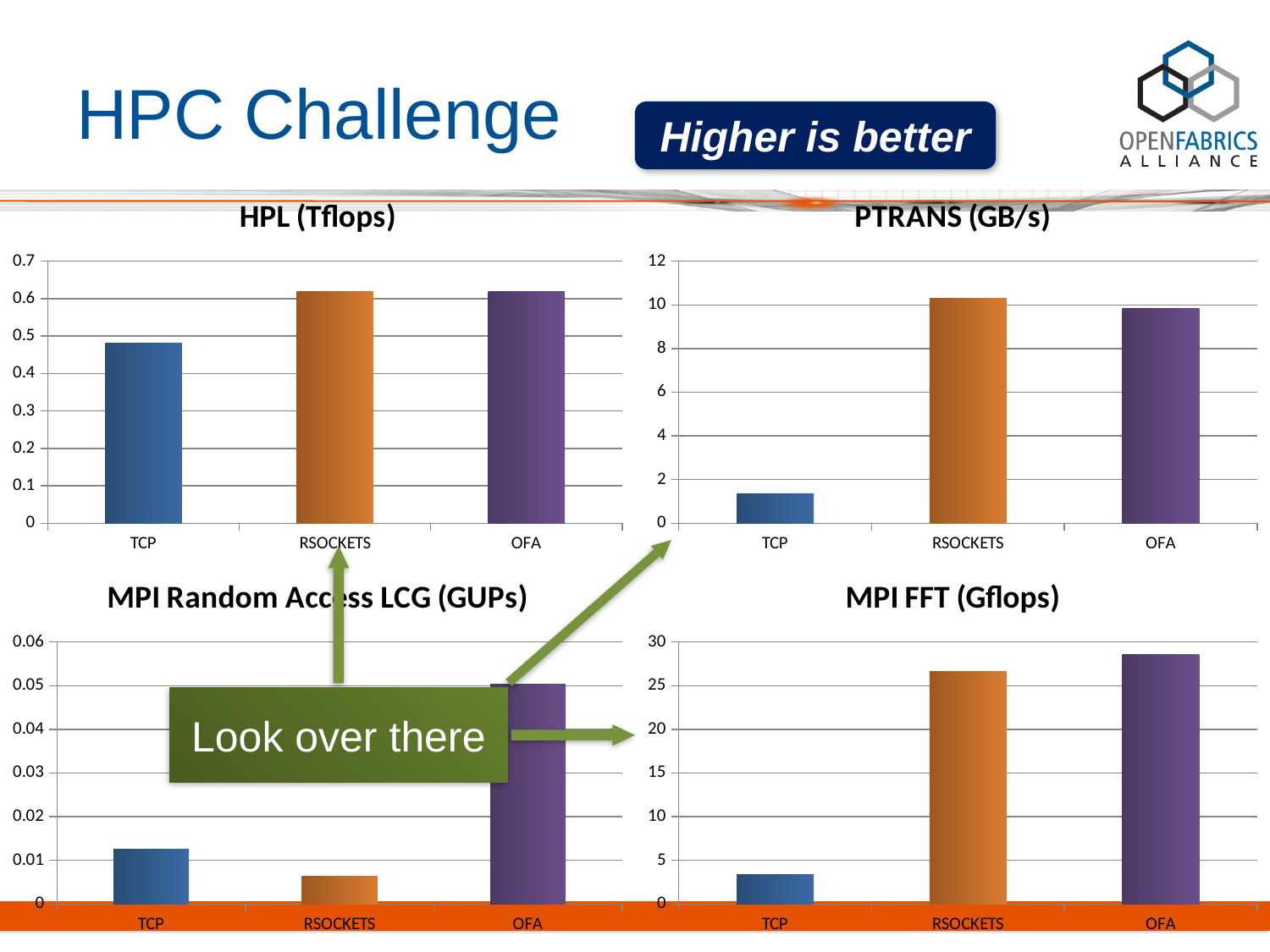
In the MPI Random Access LCG (GUPs) chart, which category has the highest value? OFA In the MPI FFT (Gflops) chart, is the value for RSOCKETS greater or less than 25? greater In the HPL (Tflops) chart, which category has the lowest value? TCP In the MPI Random Access LCG (GUPs) chart, which category has the lowest value? RSOCKETS In the HPL (Tflops) chart, is the value for RSOCKETS greater or less than 0.5? greater What kind of chart is the PTRANS (GB/s) chart? bar chart In the MPI FFT (Gflops) chart, which category has the lowest value? TCP How many categories are shown in the MPI FFT (Gflops) chart? 3 In the PTRANS (GB/s) chart, which category has the highest value? RSOCKETS In the PTRANS (GB/s) chart, which is larger, the value for OFA or the value for TCP? OFA In the PTRANS (GB/s) chart, is the value for TCP greater or less than 2? less